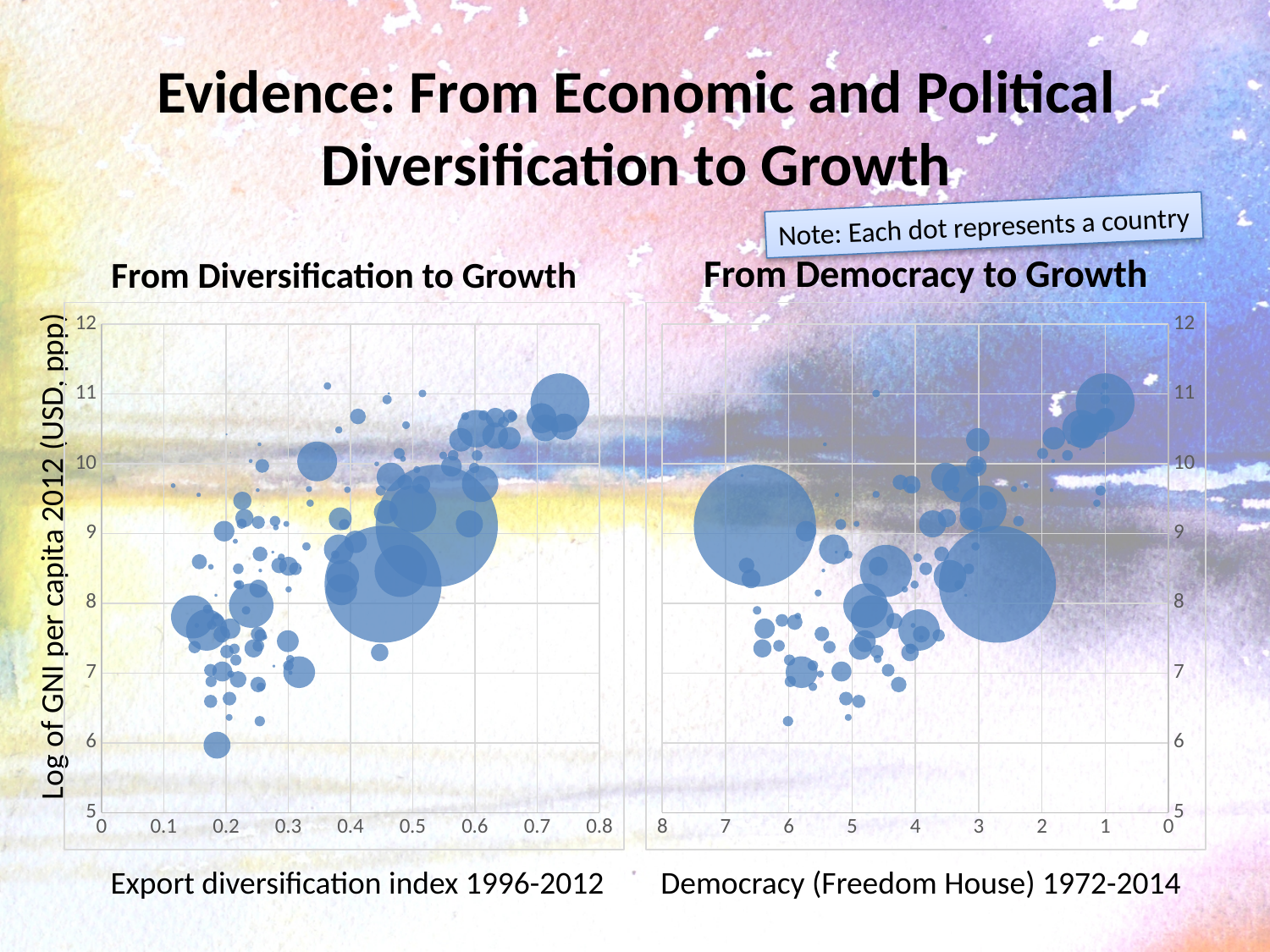
What kind of chart is the right chart titled "From Democracy to Growth"? bubble chart What kind of chart is the left chart titled "From Diversification to Growth"? bubble chart According to the note on the slide, what does each dot in the charts represent? a country In the left chart "From Diversification to Growth", do the values of log GNI per capita generally rise or fall as the export diversification index increases along the x axis? rise What is the label of the shared vertical axis of the two charts? Log of GNI per capita 2012 (USD, ppp) In the right chart "From Democracy to Growth", do the values of log GNI per capita generally rise or fall moving from left to right along the x axis? rise